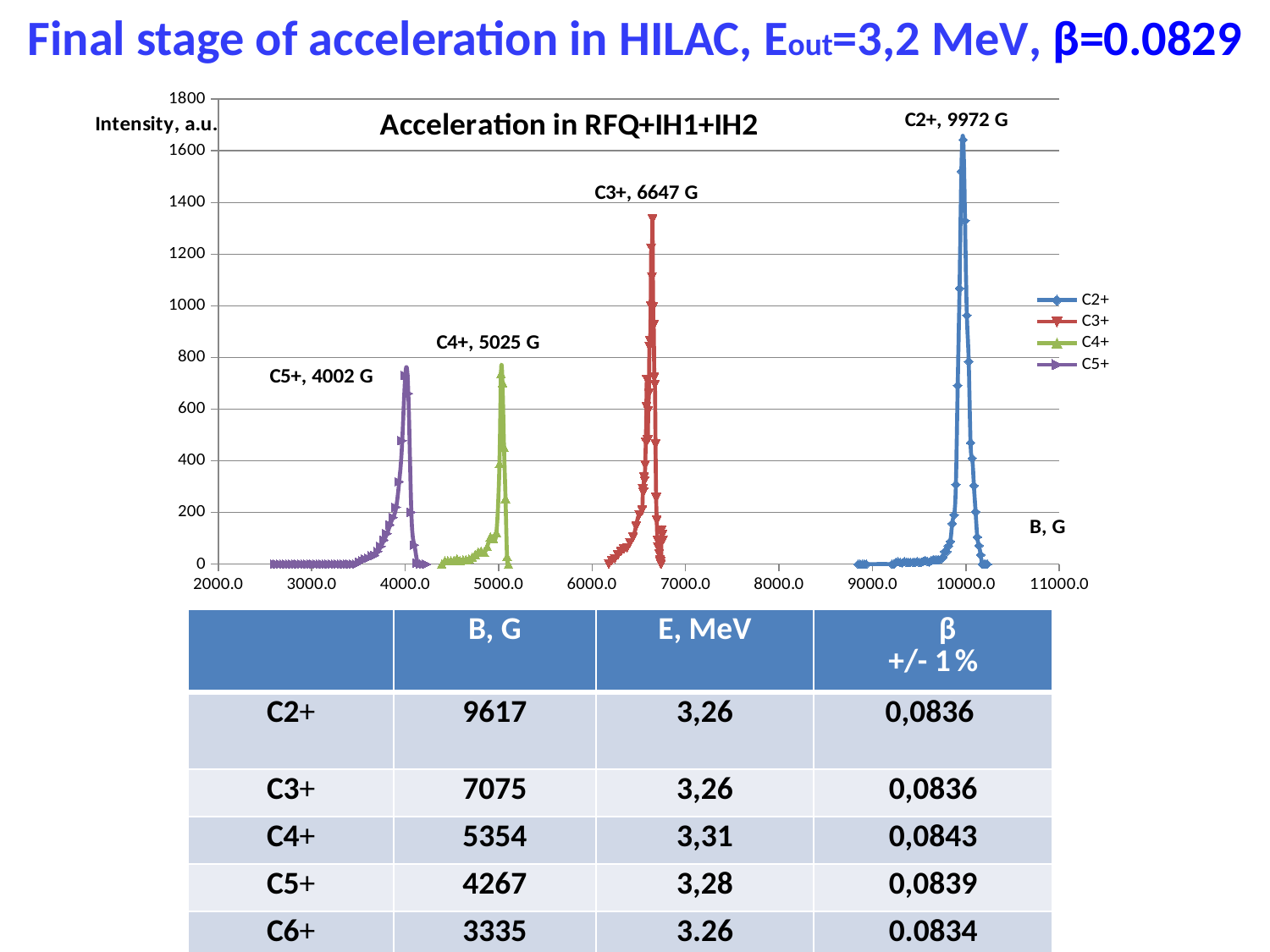
How many series does the chart legend list? 4 What is the difference between the annotated peak field of C2+ and that of C3+? 3325 G What is the title of the chart? Acceleration in RFQ+IH1+IH2 Is the peak intensity of the C4+ series greater or less than 1000? less What is the label on the vertical axis of the chart? Intensity, a.u. Is the peak intensity of the C2+ series greater or less than 1400? greater At what magnetic field does the C3+ peak occur, according to the chart annotation? 6647 G At what magnetic field does the C4+ peak occur, according to the chart annotation? 5025 G At what magnetic field does the C5+ peak occur, according to the chart annotation? 4002 G What kind of chart is shown on the slide? line chart Which series reaches the highest peak intensity in the chart? C2+ Which series has the higher peak intensity, C3+ or C4+? C3+